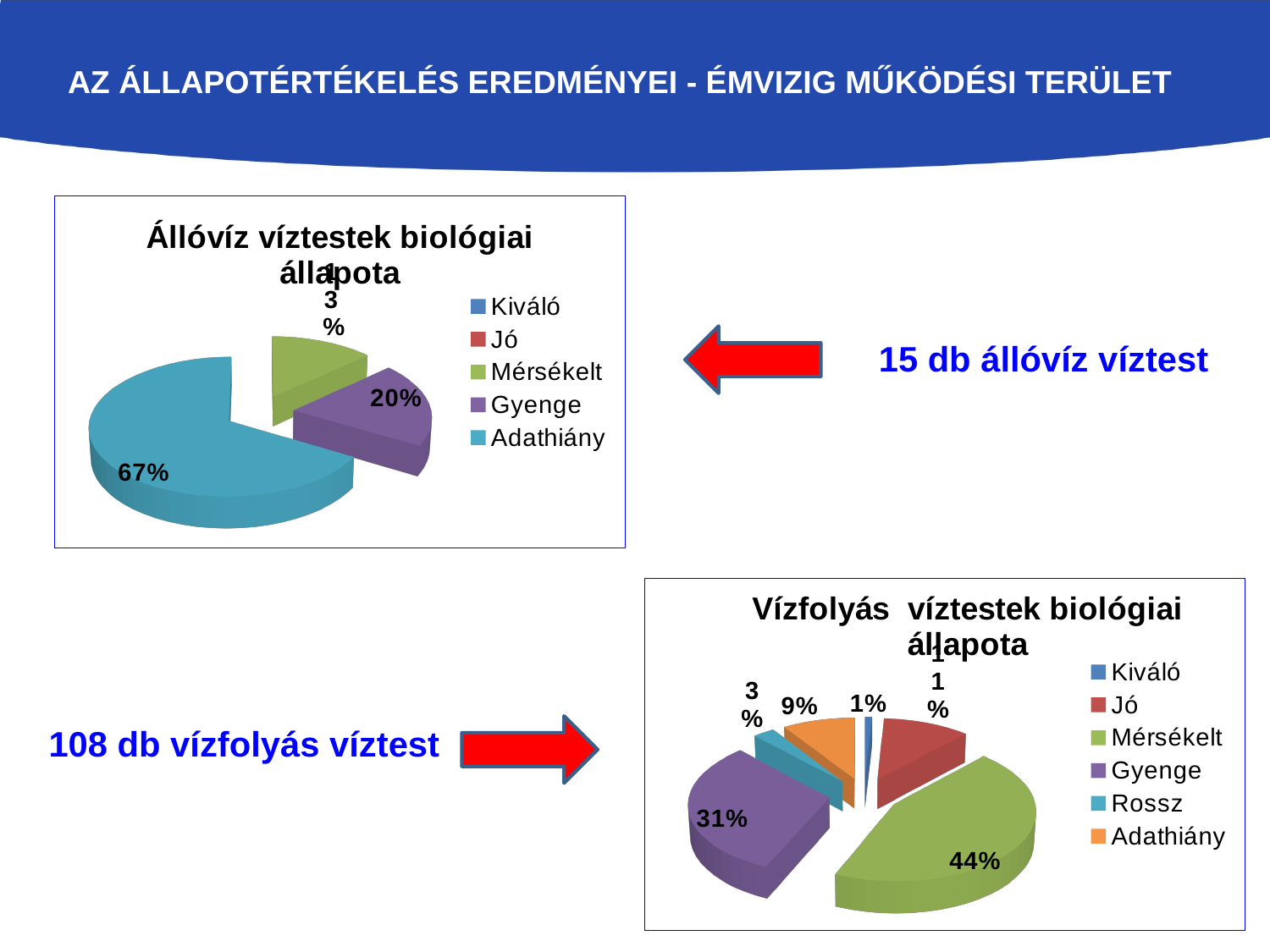
What kind of chart is the 'Állóvíz víztestek biológiai állapota' chart? Pie chart How many entries does the legend of the 'Vízfolyás víztestek biológiai állapota' chart list? 6 In the 'Állóvíz víztestek biológiai állapota' chart, how many percentage points larger is Adathiány than Gyenge? 47 percentage points In the 'Vízfolyás víztestek biológiai állapota' chart, what share is labelled for Rossz? 3% In the 'Vízfolyás víztestek biológiai állapota' chart, what share is labelled for Gyenge? 31% In the 'Vízfolyás víztestek biológiai állapota' chart, which is larger, Gyenge or Adathiány? Gyenge In the 'Vízfolyás víztestek biológiai állapota' chart, what share is labelled for Adathiány? 9% In the 'Vízfolyás víztestek biológiai állapota' chart, what share is labelled for Mérsékelt? 44% In the 'Állóvíz víztestek biológiai állapota' chart, what share is labelled for Adathiány? 67% How many entries does the legend of the 'Állóvíz víztestek biológiai állapota' chart list? 5 In the 'Állóvíz víztestek biológiai állapota' chart, which category has the largest slice? Adathiány In the 'Állóvíz víztestek biológiai állapota' chart, what share is labelled for Gyenge? 20%